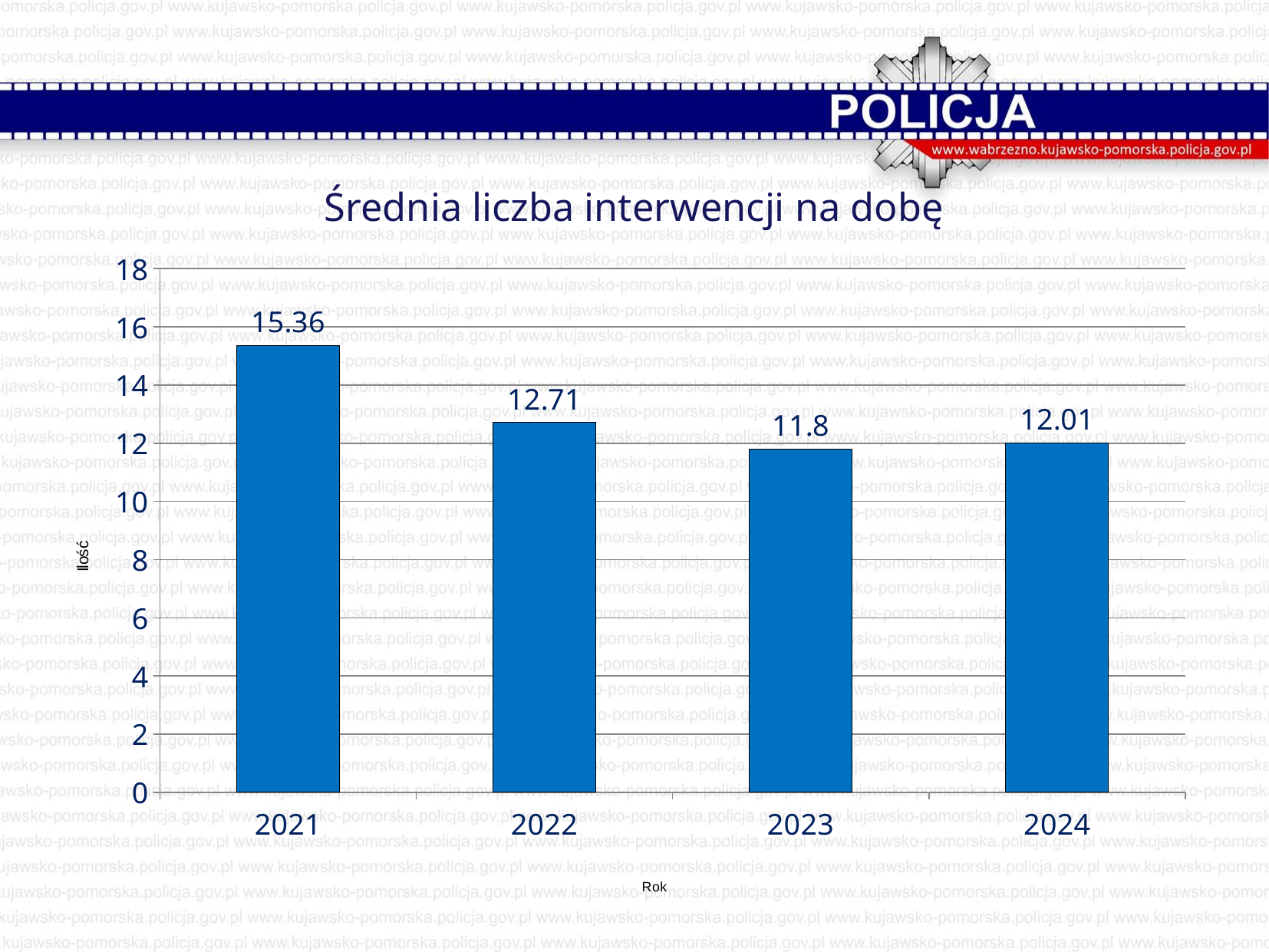
What is the title of the chart? Średnia liczba interwencji na dobę Is the value for 2021 greater or less than 14? greater What is the average number of interventions per day in 2021? 15.36 What is the value shown for 2023? 11.8 Which year has the lowest average number of interventions per day? 2023 What is the value shown for 2024? 12.01 What is the difference between the values for 2024 and 2023? 0.21 What kind of chart is shown on the slide? bar chart What is the difference between the values for 2021 and 2022? 2.65 How many years are shown on the chart? 4 Which is larger, the value for 2022 or the value for 2024? 2022 Which year has the highest average number of interventions per day? 2021